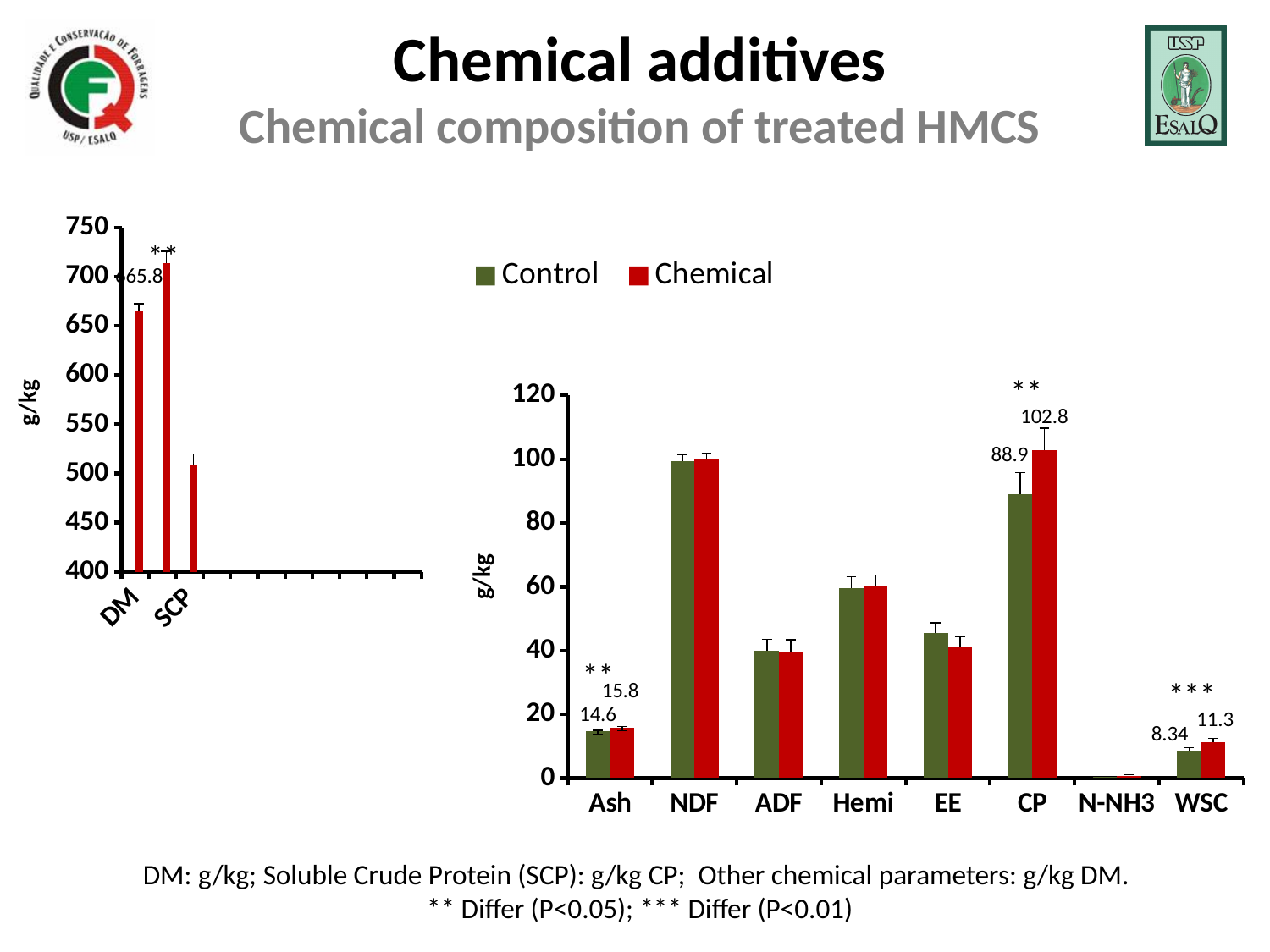
On the right chart, what is the Chemical value for CP? 102.8 On the right chart, which is larger for WSC, the Control value or the Chemical value? Chemical How many categories are shown on the x axis of the right chart? 8 On the right chart, which category has the lowest values? N-NH3 On the right chart, what is the difference between the Chemical and Control values for CP? 13.9 On the right chart, what is the Chemical value for Ash? 15.8 On the right chart, is the Chemical value for Hemi greater or less than 80? less On the right chart, what is the Control value for CP? 88.9 On the right chart, what is the Control value for WSC? 8.34 How many series does the legend list? 2 On the right chart, is the Control value for NDF greater or less than 80? greater What kind of chart is the right chart? bar chart